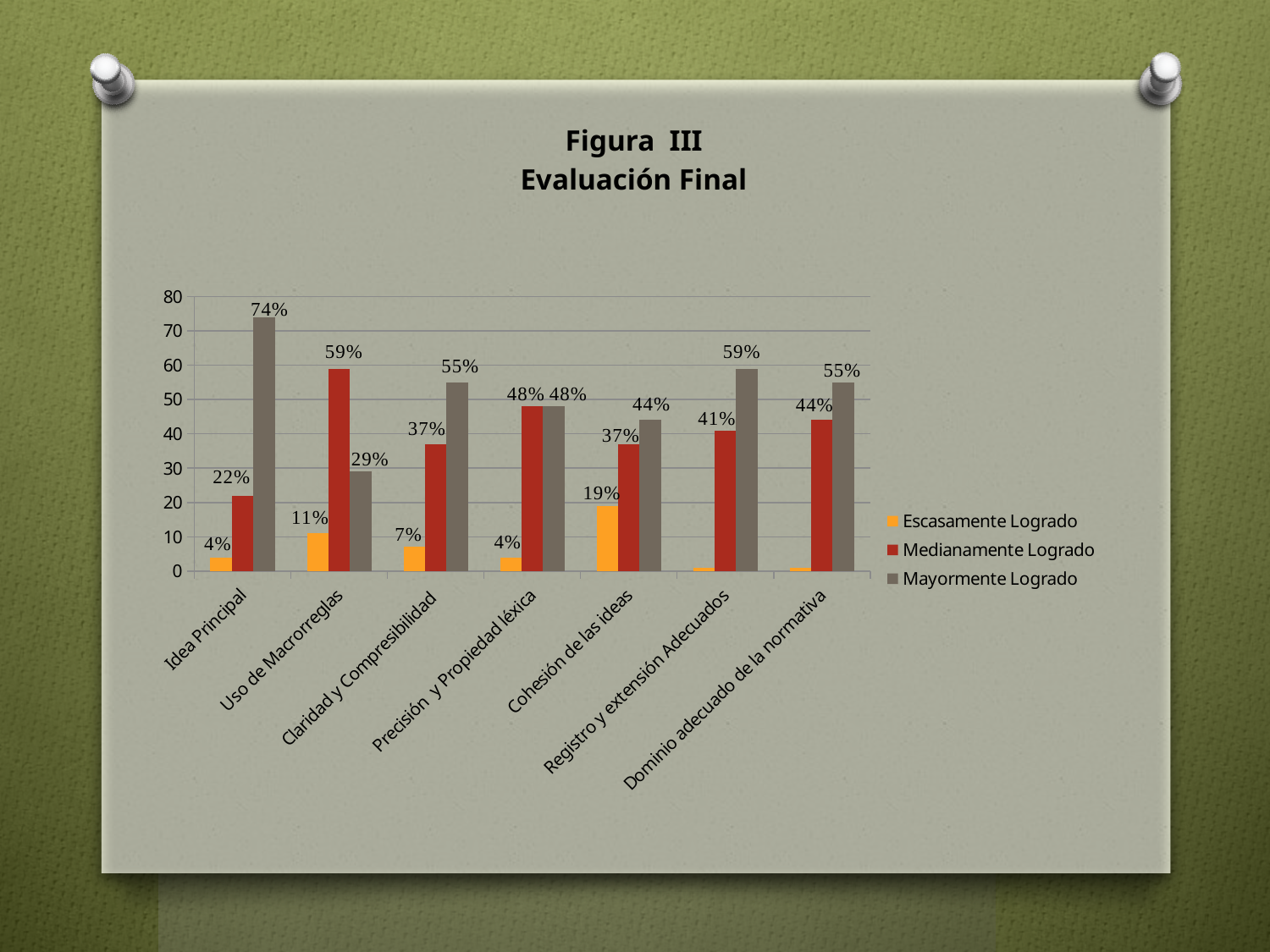
How many series does the legend list? 3 Which category has the highest value for Mayormente Logrado? Idea Principal How many categories are shown on the x axis? 7 What is the value for Medianamente Logrado in the Uso de Macrorreglas category? 59% Which category has the highest value for Escasamente Logrado? Cohesión de las ideas What kind of chart is shown on the slide? Bar chart What is the difference between Mayormente Logrado and Medianamente Logrado in the Idea Principal category? 52% What is the value for Mayormente Logrado in the Dominio adecuado de la normativa category? 55% What is the value for Escasamente Logrado in the Cohesión de las ideas category? 19% In the Uso de Macrorreglas category, which is larger: Medianamente Logrado or Mayormente Logrado? Medianamente Logrado What is the value for Mayormente Logrado in the Idea Principal category? 74% Which category has the lowest value for Medianamente Logrado? Idea Principal